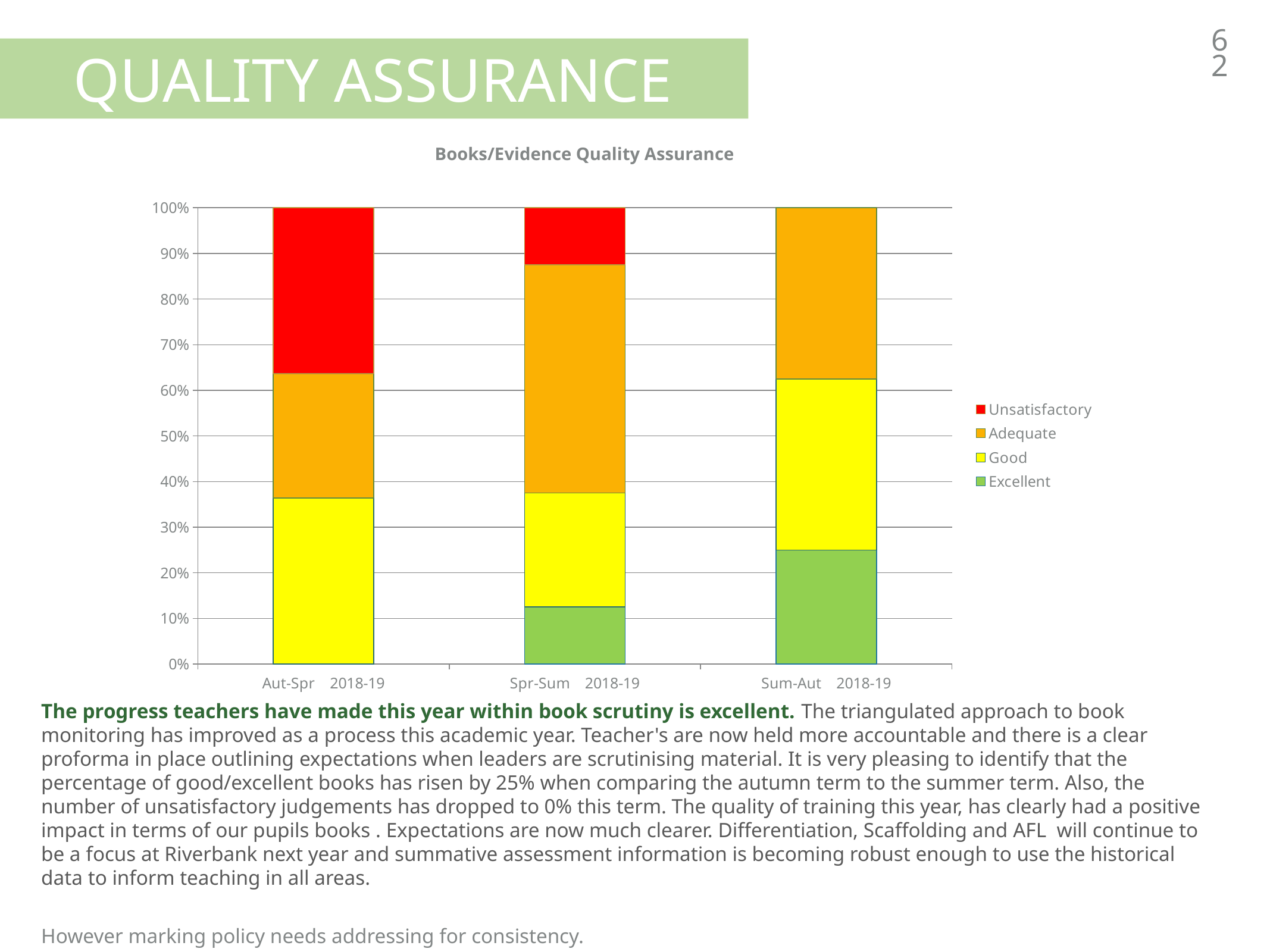
Which period has the larger Unsatisfactory share, Aut-Spr 2018-19 or Spr-Sum 2018-19? Aut-Spr 2018-19 Which period has the largest Unsatisfactory segment? Aut-Spr 2018-19 Is the Unsatisfactory share for Aut-Spr 2018-19 greater or less than 30%? greater Which period has the largest Adequate segment? Spr-Sum 2018-19 How many series does the chart legend list? 4 Is the Excellent share for Sum-Aut 2018-19 greater or less than 20%? greater Which colour represents the Unsatisfactory series in the chart? Red How many bars (time periods) are plotted on the chart? 3 Which period has the largest Excellent segment? Sum-Aut 2018-19 What kind of chart is shown on the slide? Stacked bar chart Does the Excellent share rise or fall across the three periods from Aut-Spr to Sum-Aut? Rise What is the title of the chart? Books/Evidence Quality Assurance